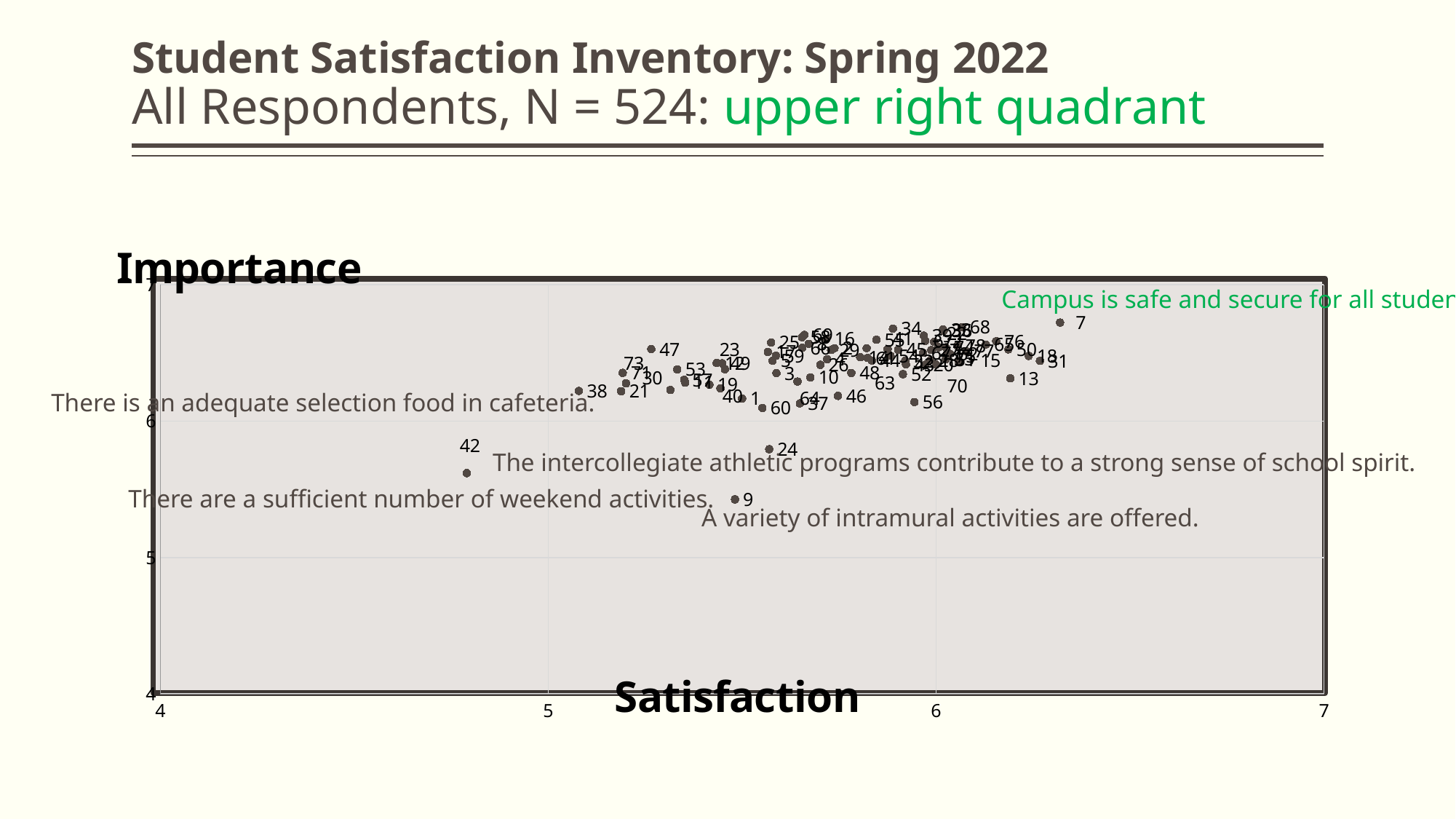
Is the Importance value for point 38 greater or less than 6? greater Which labeled point has the lowest Importance value? 9 Which has the higher Satisfaction value, point 42 or point 9? 9 Is the Satisfaction value for point 13 greater or less than 6? greater What is the label of the vertical axis of the chart? Importance What kind of chart is shown on the slide? scatter plot Is the Importance value for point 9 greater or less than 6? less What is the label of the horizontal axis of the chart? Satisfaction Which labeled point has the lowest Satisfaction value? 42